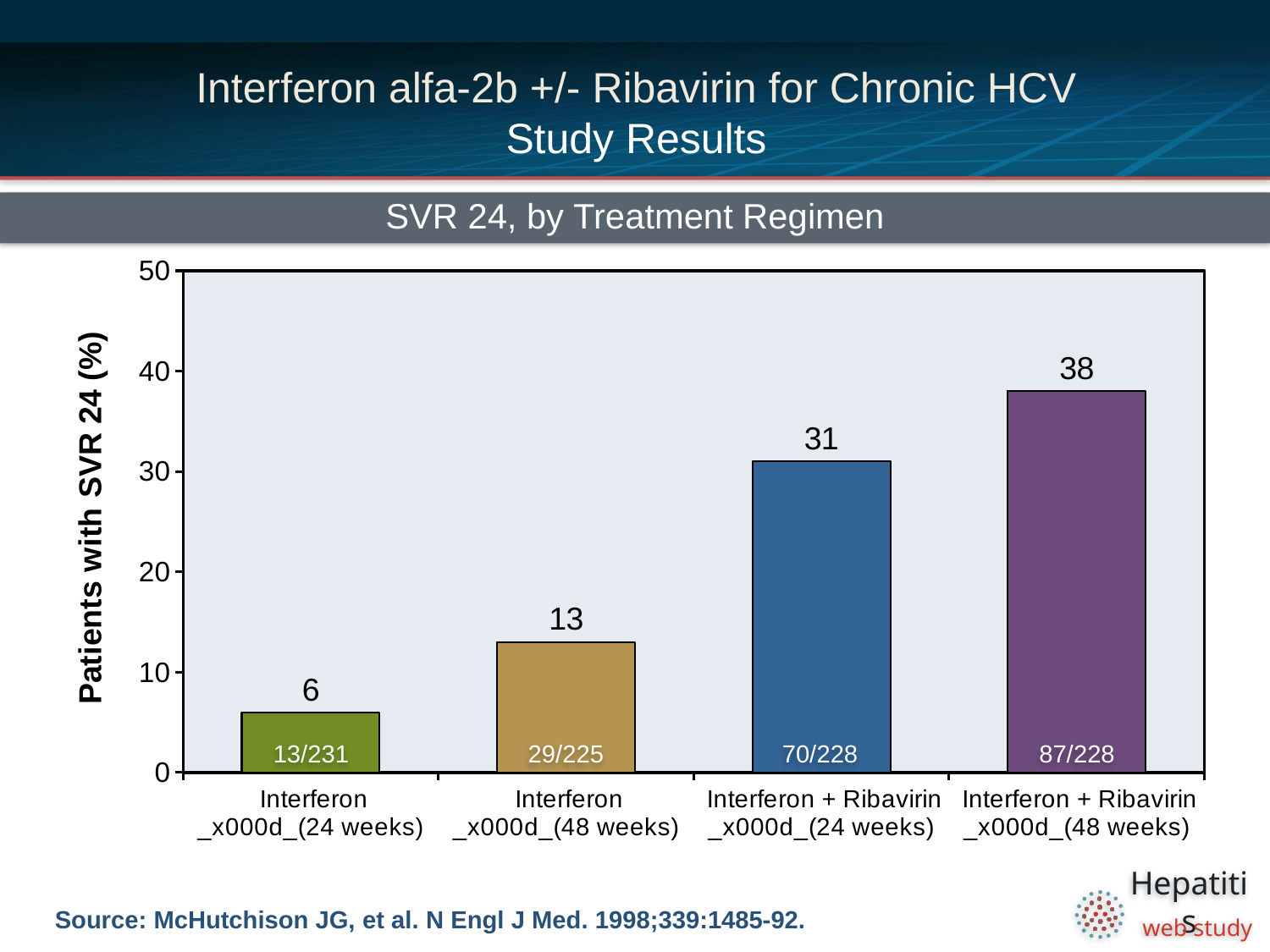
How many treatment regimens are shown on the chart? 4 What kind of chart is shown on the slide? bar chart What fraction is printed inside the bar for Interferon + Ribavirin (24 weeks)? 70/228 Which is larger, the value for Interferon (48 weeks) or Interferon + Ribavirin (24 weeks)? Interferon + Ribavirin (24 weeks) Which treatment regimen has the lowest percentage of patients with SVR 24? Interferon (24 weeks) What is the value for Interferon (48 weeks)? 13 Which treatment regimen has the highest percentage of patients with SVR 24? Interferon + Ribavirin (48 weeks) Do the values rise or fall from left to right across the treatment regimens? rise What is the difference between the values for Interferon + Ribavirin (48 weeks) and Interferon + Ribavirin (24 weeks)? 7 Is the value for Interferon + Ribavirin (24 weeks) greater or less than 20? greater What is the value for Interferon (24 weeks)? 6 What is the value for Interferon + Ribavirin (48 weeks)? 38